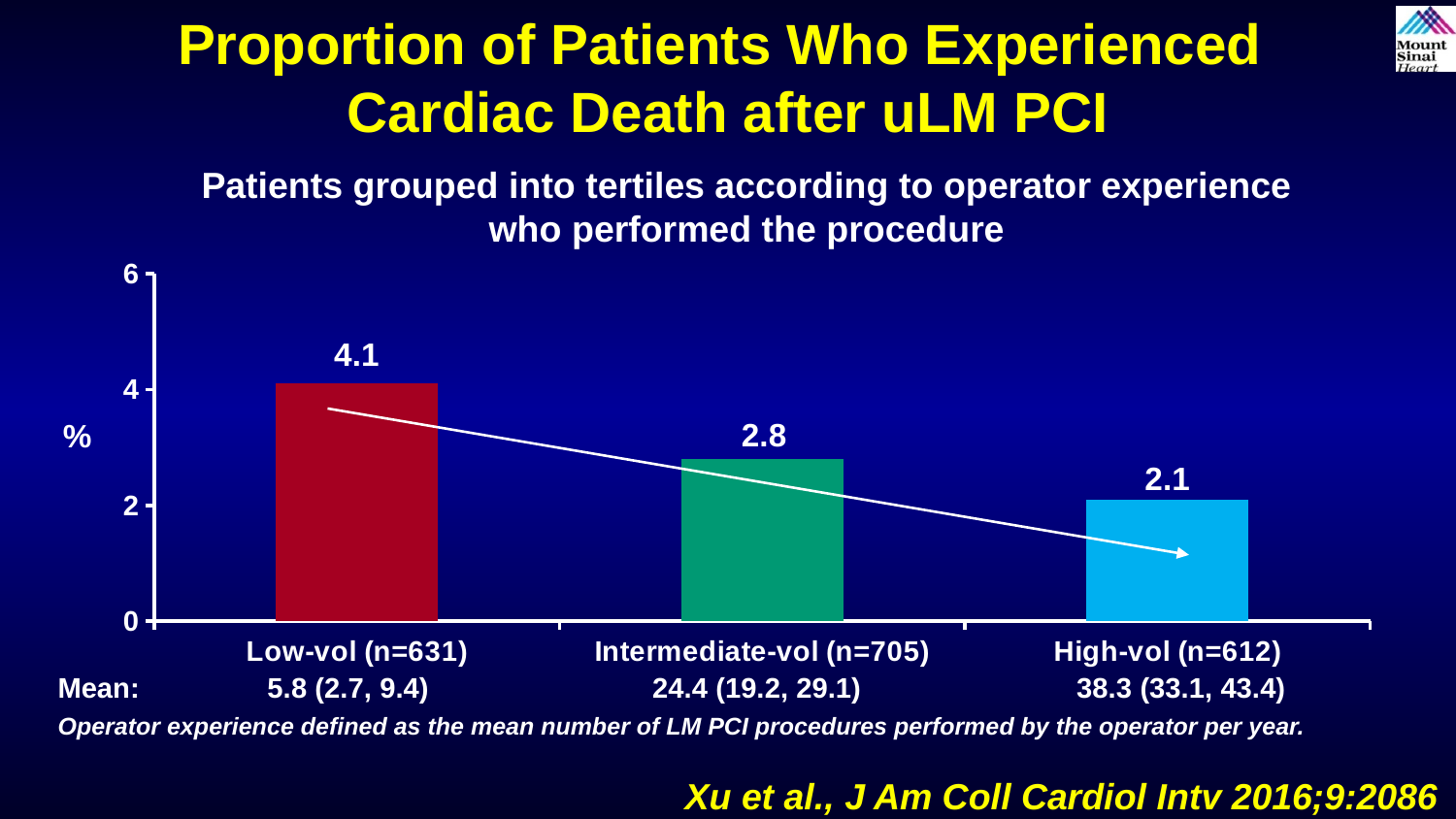
Which group has the lowest proportion of cardiac death? High-vol (n=612) What is the value for the High-vol (n=612) group? 2.1 What is the difference between the Low-vol and High-vol values? 2.0 Do the values rise or fall from Low-vol to High-vol? Fall What is the difference between the Low-vol and Intermediate-vol values? 1.3 What kind of chart is shown on the slide? Bar chart How many groups are shown on the chart? 3 Which is larger, the value for Intermediate-vol or High-vol? Intermediate-vol Is the value for Low-vol greater or less than 4? greater Which group has the highest proportion of cardiac death? Low-vol (n=631) What is the value for the Intermediate-vol (n=705) group? 2.8 What is the value for the Low-vol (n=631) group? 4.1